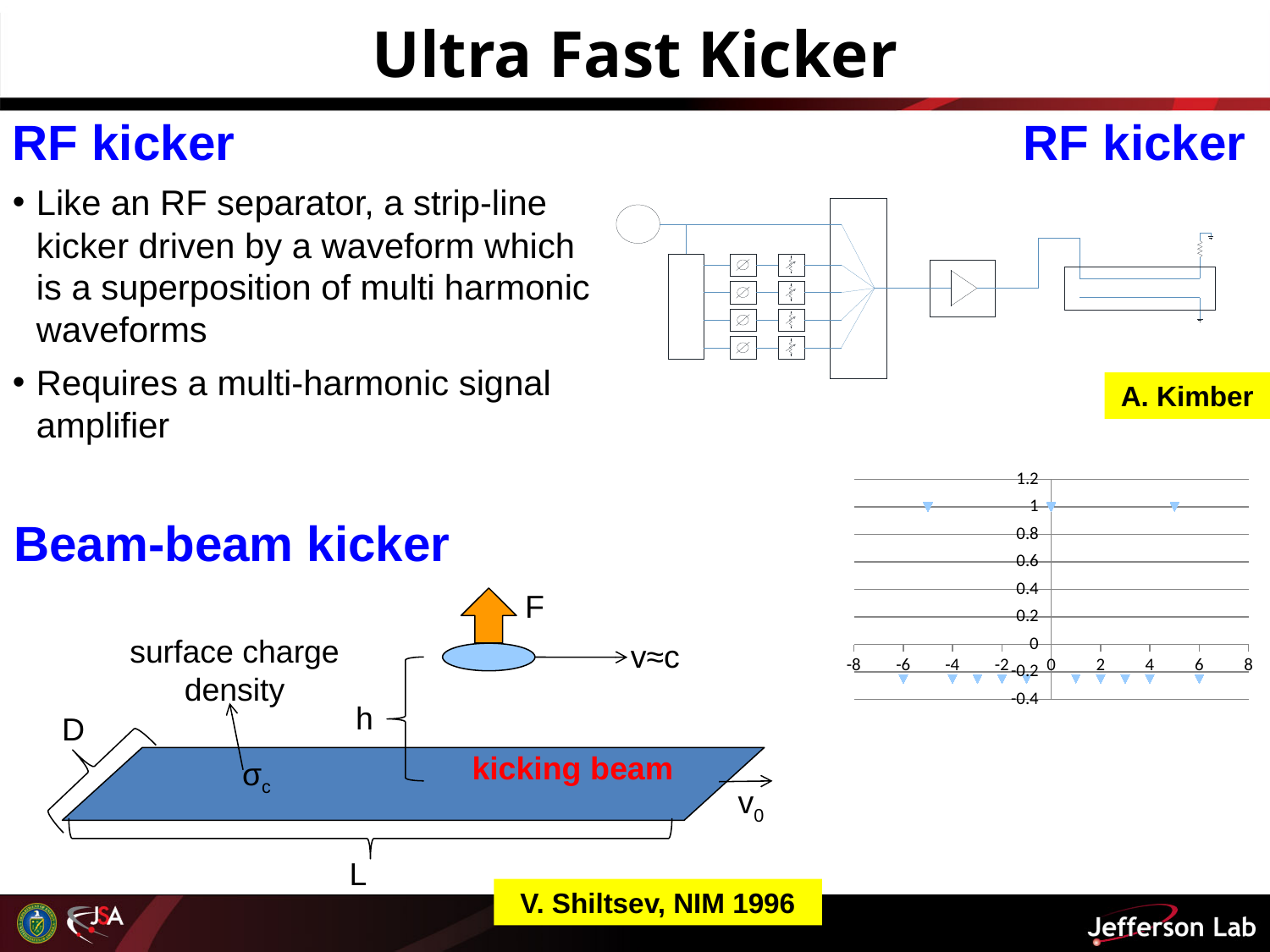
What kind of chart is shown on the right side of the slide? scatter chart In the chart on the right, is the value of the point at x = 0 greater or less than 0.5? greater What is the lowest value labelled on the x axis of the chart on the right? -8 In the chart on the right, which point has the larger value: the one at x = -4 or the one at x = -5? x = -5 In the chart on the right, is the value of the point at x = 5 greater or less than 0.8? greater In the chart on the right, is the value of the point at x = 2 greater or less than 0.2? less In the chart on the right, which point has the larger value: the one at x = 0 or the one at x = 2? x = 0 In the chart on the right, how many points lie on the y = 1 gridline? 3 What is the highest value labelled on the y axis of the chart on the right? 1.2